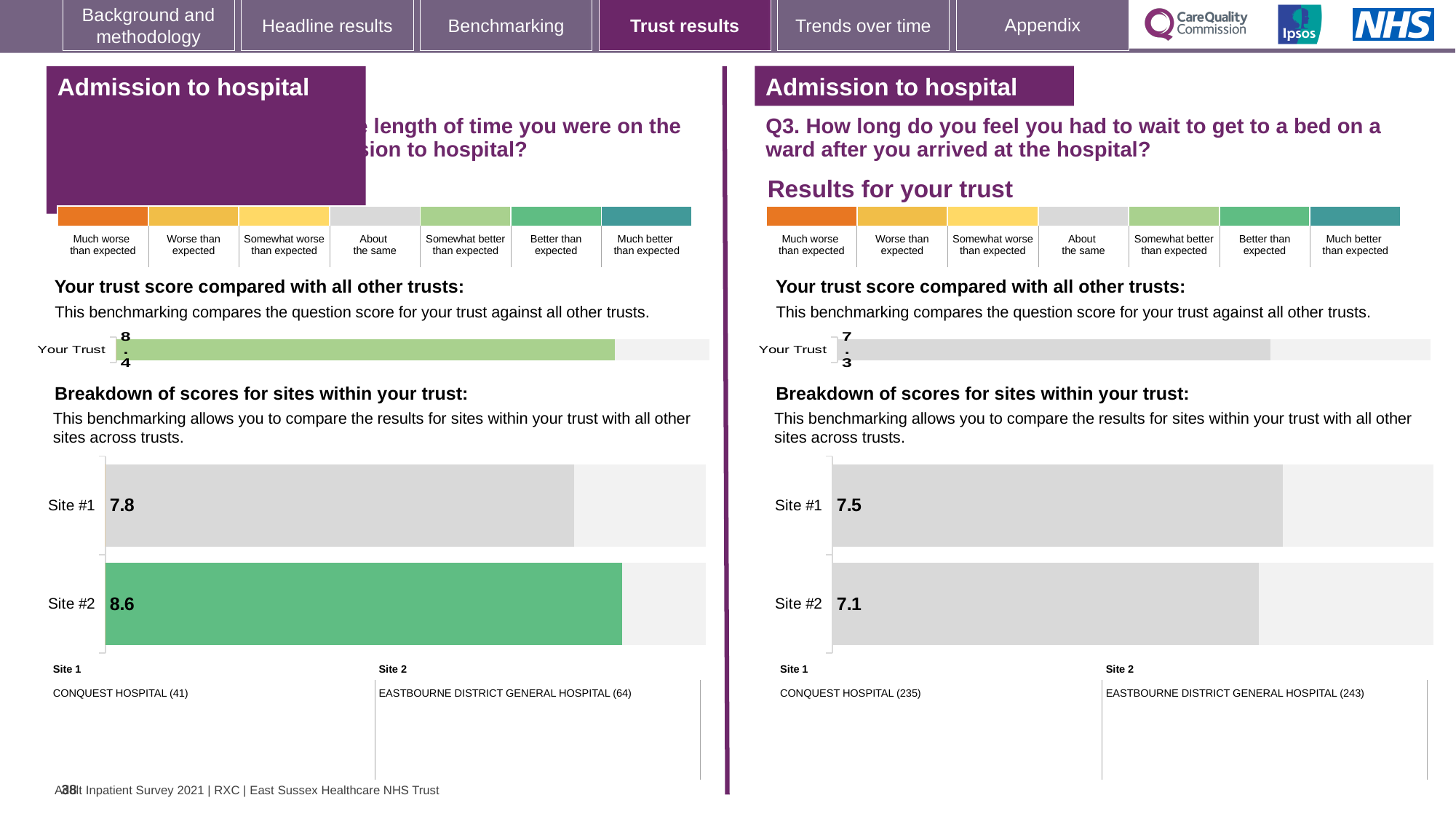
On the right-hand Q3 'Your trust score compared with all other trusts' chart, what is the score shown for Your Trust? 7.3 On the left-hand 'Breakdown of scores for sites within your trust' chart, what is the score for Site #2? 8.6 On the right-hand Q3 site breakdown chart, which site has the lower score? Site #2 On the right-hand Q3 'Breakdown of scores for sites within your trust' chart, what is the score for Site #2? 7.1 On the left-hand site breakdown chart, which site has the higher score? Site #2 What type of chart is used for the site breakdown on the left-hand side of the slide? Bar chart On the left-hand 'Breakdown of scores for sites within your trust' chart, what is the score for Site #1? 7.8 How many sites are shown on the right-hand Q3 site breakdown chart? 2 On the left-hand site breakdown chart, what is the difference between the Site #2 and Site #1 scores? 0.8 On the left-hand 'Your trust score compared with all other trusts' chart, what is the score shown for Your Trust? 8.4 On the right-hand Q3 'Breakdown of scores for sites within your trust' chart, what is the score for Site #1? 7.5 On the right-hand Q3 site breakdown chart, what is the difference between the Site #1 and Site #2 scores? 0.4